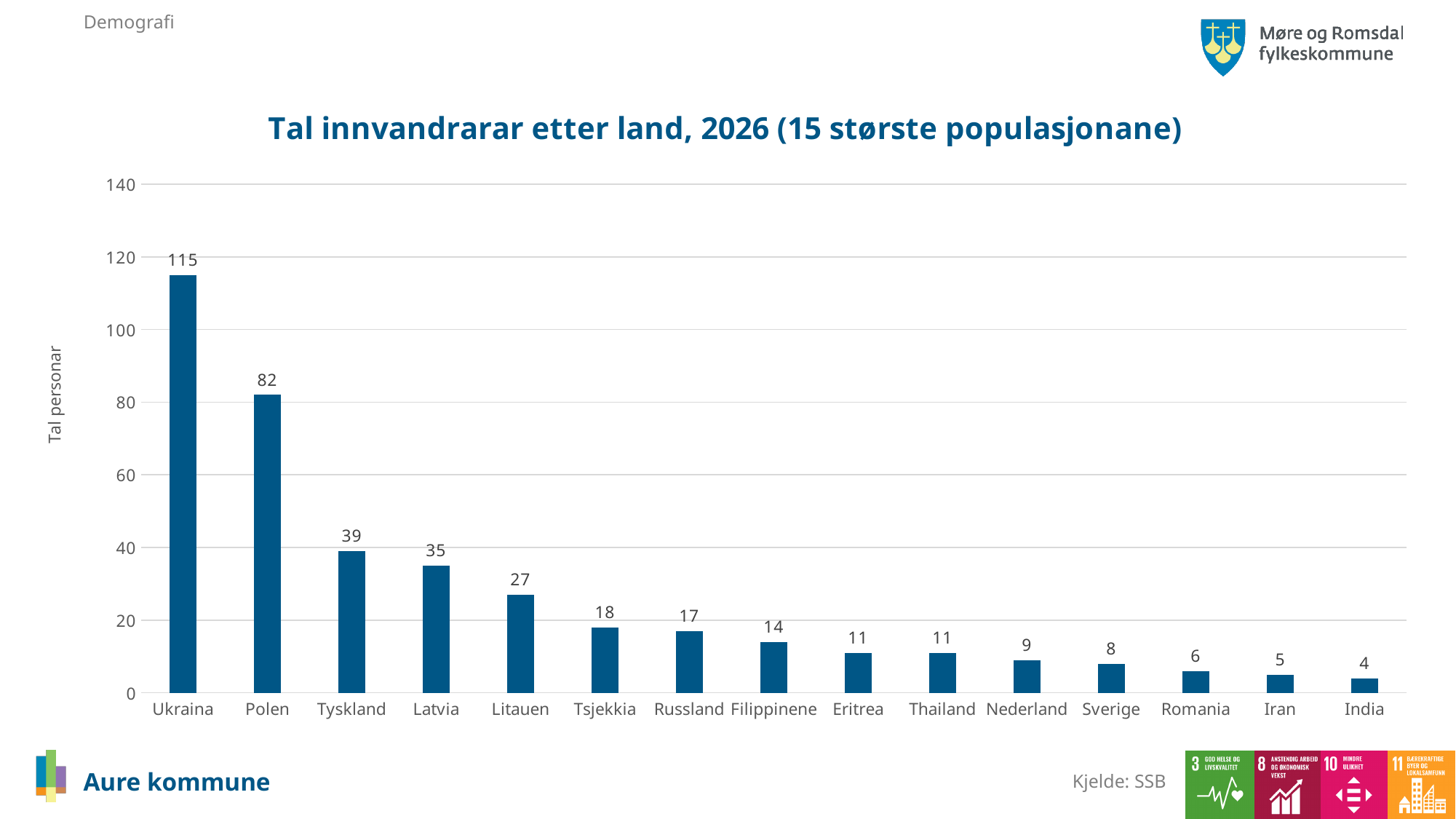
What is the difference between the values for Ukraina and Polen? 33 Which is larger, the value for Latvia or the value for Litauen? Latvia What is the title of the chart? Tal innvandrarar etter land, 2026 (15 største populasjonane) Do the values rise or fall from left to right along the x axis? fall Which country has the lowest value? India How many countries are shown on the chart? 15 Which country has the highest value? Ukraina What kind of chart is this? bar chart What is the value for Tyskland? 39 Is the value for Polen greater or less than 100? less What is the value for Filippinene? 14 What is the value for Ukraina? 115